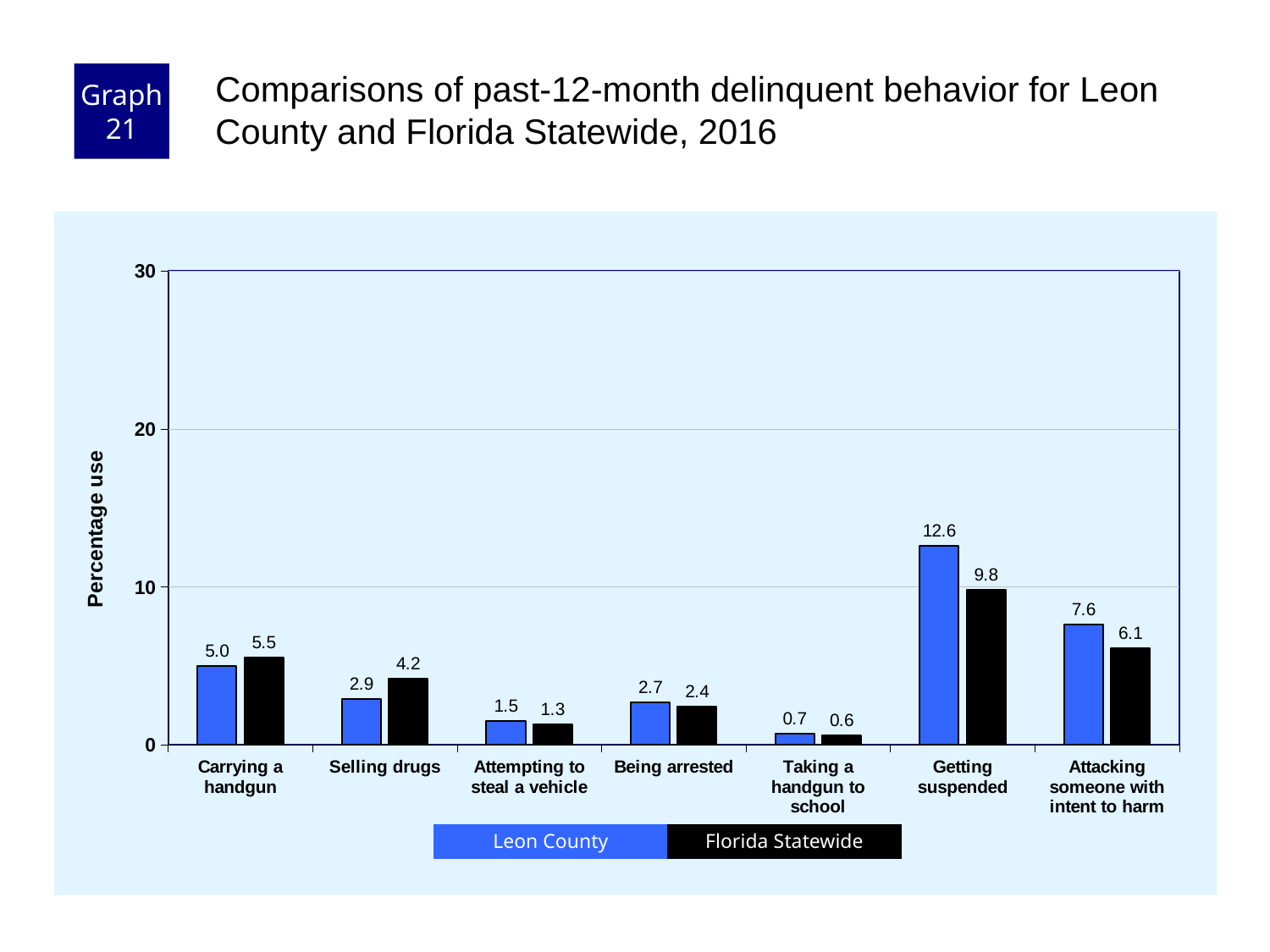
What kind of chart is shown on the slide? bar chart What is the difference between the Florida Statewide and Leon County values for Carrying a handgun? 0.5 What is the Florida Statewide value for Selling drugs? 4.2 Which category has the highest Florida Statewide value? Getting suspended What is the difference between the Leon County and Florida Statewide values for Getting suspended? 2.8 Which is larger for Attacking someone with intent to harm: Leon County or Florida Statewide? Leon County How many series does the legend list? 2 What is the Leon County value for Taking a handgun to school? 0.7 Is the Leon County value for Getting suspended greater or less than 10? greater Which category has the lowest Leon County value? Taking a handgun to school How many categories are shown on the x axis? 7 What is the Leon County value for Getting suspended? 12.6